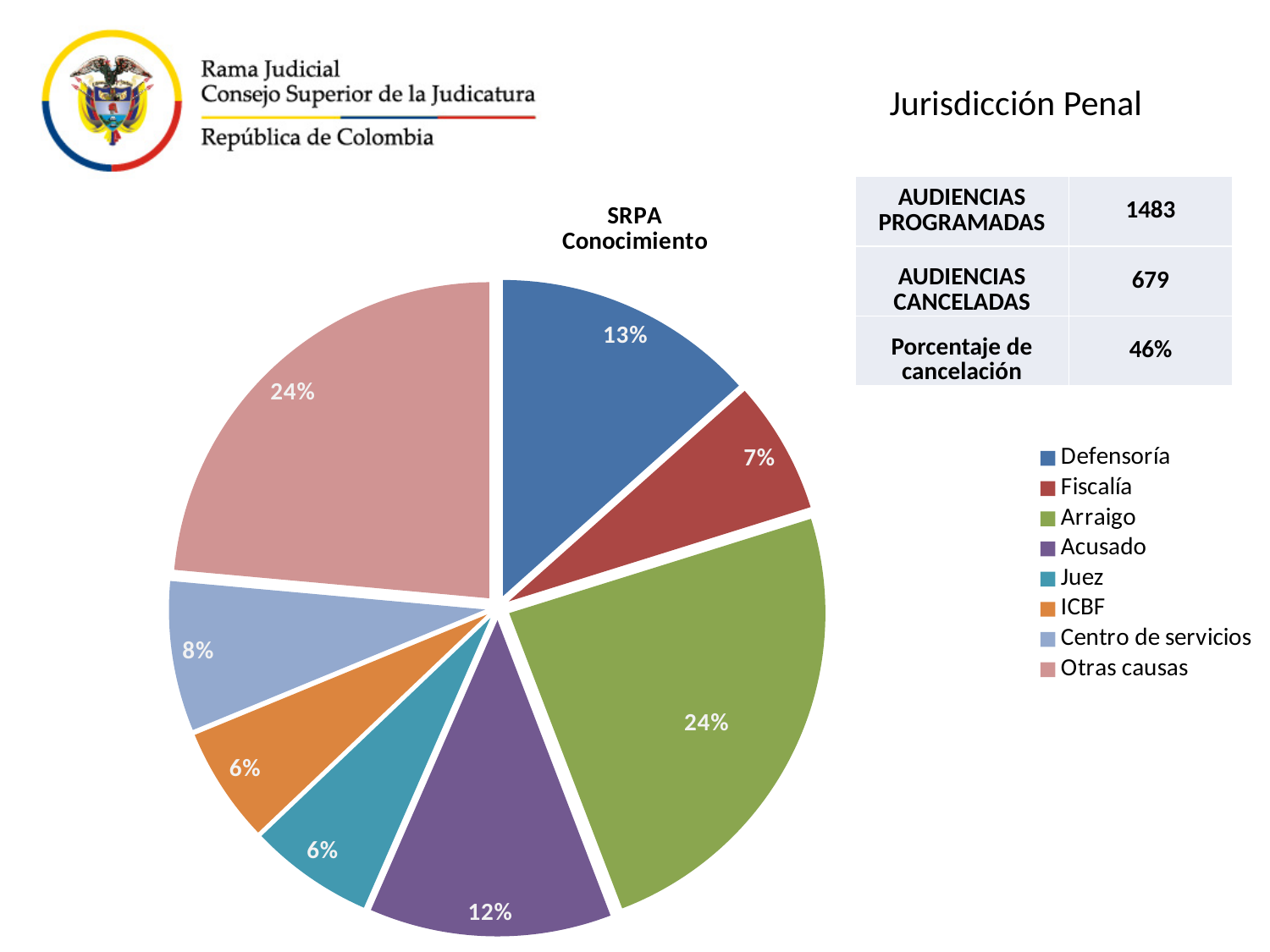
Which is larger, the share for Centro de servicios or the share for Juez? Centro de servicios What percentage of the pie does Centro de servicios account for? 8% What is the difference in percentage points between the Arraigo slice and the Acusado slice? 12 Which is larger, the share for Defensoría or the share for Fiscalía? Defensoría What is the title of the pie chart? SRPA Conocimiento What percentage of the pie does Acusado account for? 12% What percentage of the pie does Fiscalía account for? 7% What percentage of the pie does Arraigo account for? 24% What percentage of the pie does Otras causas account for? 24% How many categories does the legend of the pie chart list? 8 What percentage of the pie does Defensoría account for? 13% What type of chart is shown on the slide? Pie chart